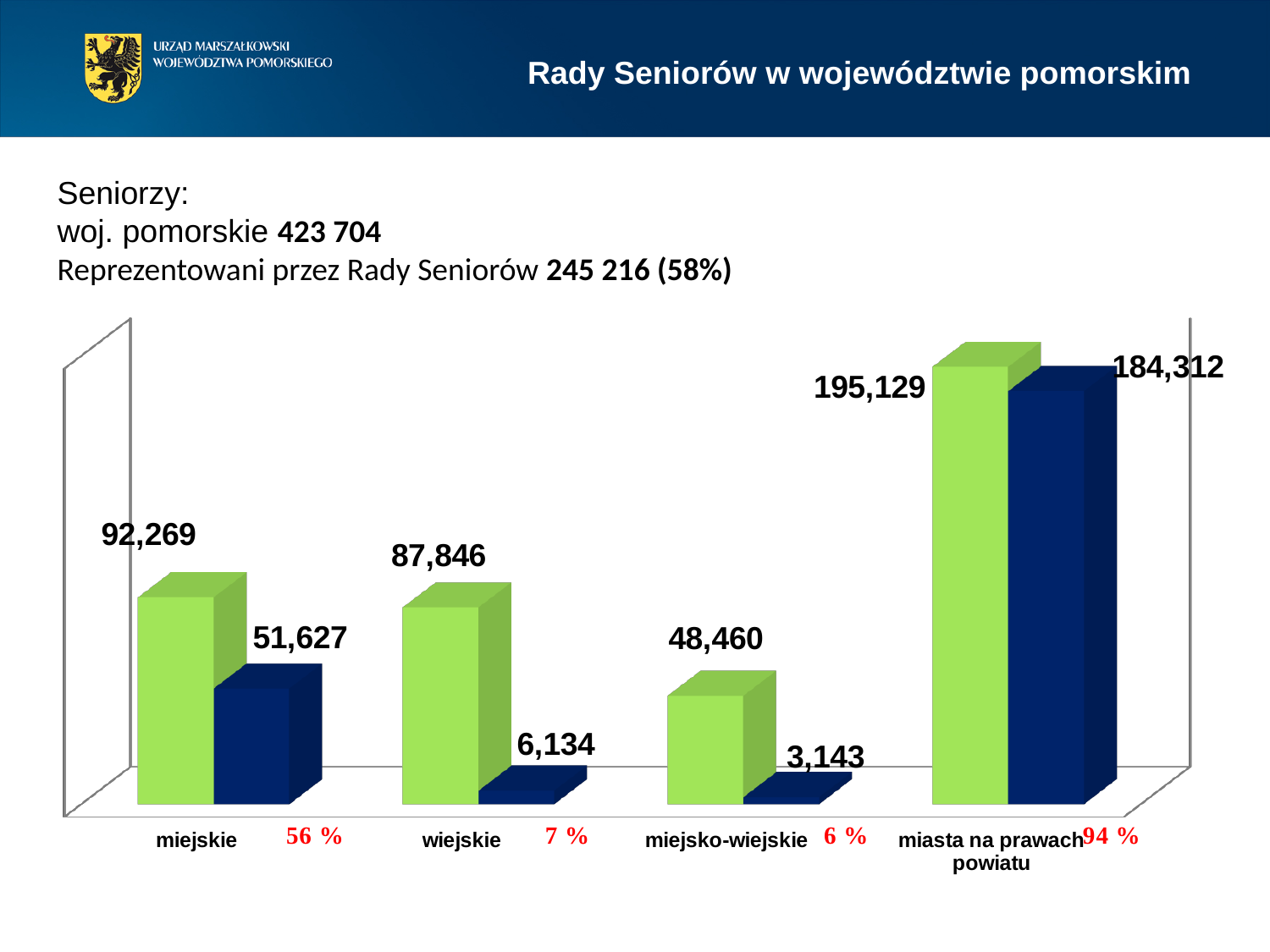
Which category has the lowest dark blue bar? miejsko-wiejskie What is the difference between the green and dark blue bars for miasta na prawach powiatu? 10,817 Which category has the highest green bar? miasta na prawach powiatu What red percentage is shown under the miasta na prawach powiatu category? 94 % What is the value of the green bar for miejskie? 92,269 What is the difference between the green and dark blue bars for miejskie? 40,642 Which is larger: the green bar for wiejskie or the green bar for miejskie? miejskie What is the value of the green bar for miejsko-wiejskie? 48,460 What is the value of the dark blue bar for wiejskie? 6,134 What is the value of the dark blue bar for miasta na prawach powiatu? 184,312 How many categories are shown on the x axis? 4 What type of chart is shown on the slide? bar chart